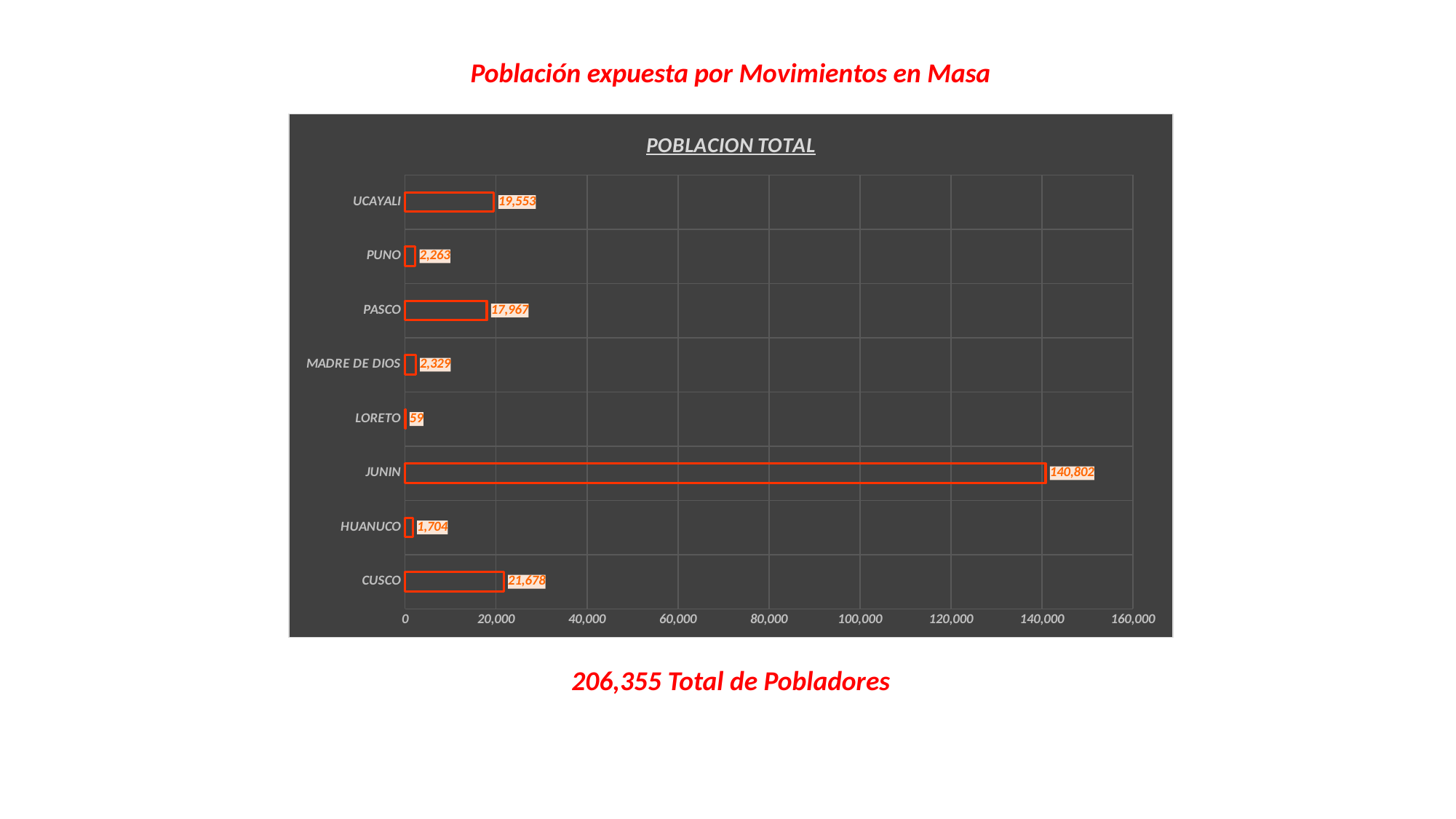
What is the value for MADRE DE DIOS? 2,329 What is the title of the chart? POBLACION TOTAL Which category has the lowest value? LORETO Which category has the highest value? JUNIN What is the value for CUSCO? 21,678 What is the value for LORETO? 59 Is the value for JUNIN greater or less than 120,000? greater Which is larger, the value for PASCO or the value for UCAYALI? UCAYALI How many categories are shown in the chart? 8 What kind of chart is shown? bar chart What is the value for JUNIN? 140,802 What is the difference between the values for CUSCO and UCAYALI? 2,125